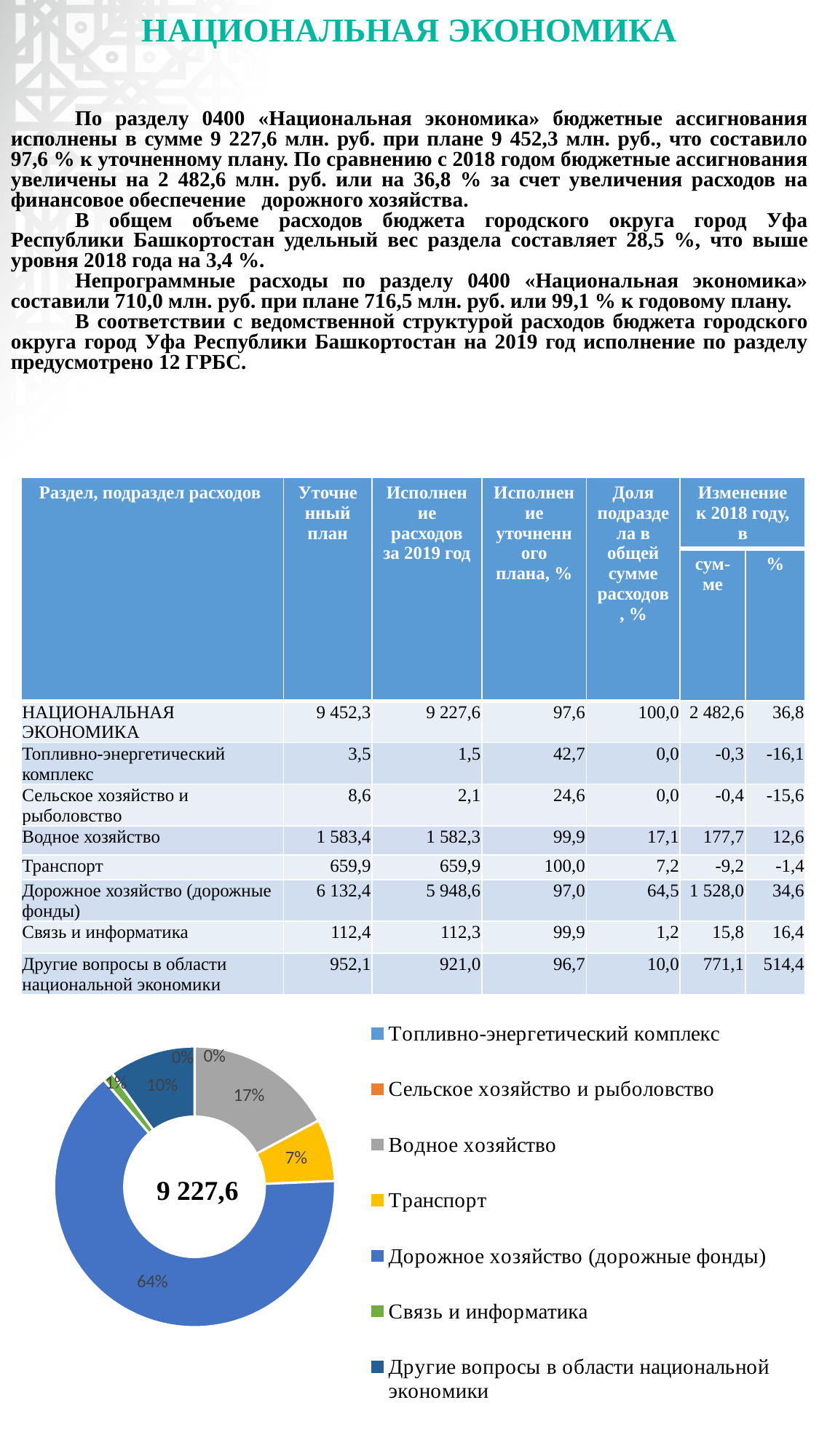
In the pie chart, which has the larger share: Водное хозяйство or Другие вопросы в области национальной экономики? Водное хозяйство What number is printed in the centre of the doughnut chart? 9 227,6 By how many percentage points does the share of Дорожное хозяйство (дорожные фонды) exceed the share of Водное хозяйство in the pie chart? 47 percentage points How many entries does the legend of the pie chart list? 7 Which category has the largest slice in the pie chart? Дорожное хозяйство (дорожные фонды) What percentage is shown for Другие вопросы в области национальной экономики in the pie chart? 10% What percentage is shown for Транспорт in the pie chart? 7% What share of the pie chart does Дорожное хозяйство (дорожные фонды) take? 64% What percentage is shown for Водное хозяйство in the pie chart? 17% What colour represents Транспорт in the pie chart? Yellow What percentage is shown for Связь и информатика in the pie chart? 1% What kind of chart is shown at the bottom of the slide? Doughnut (pie) chart